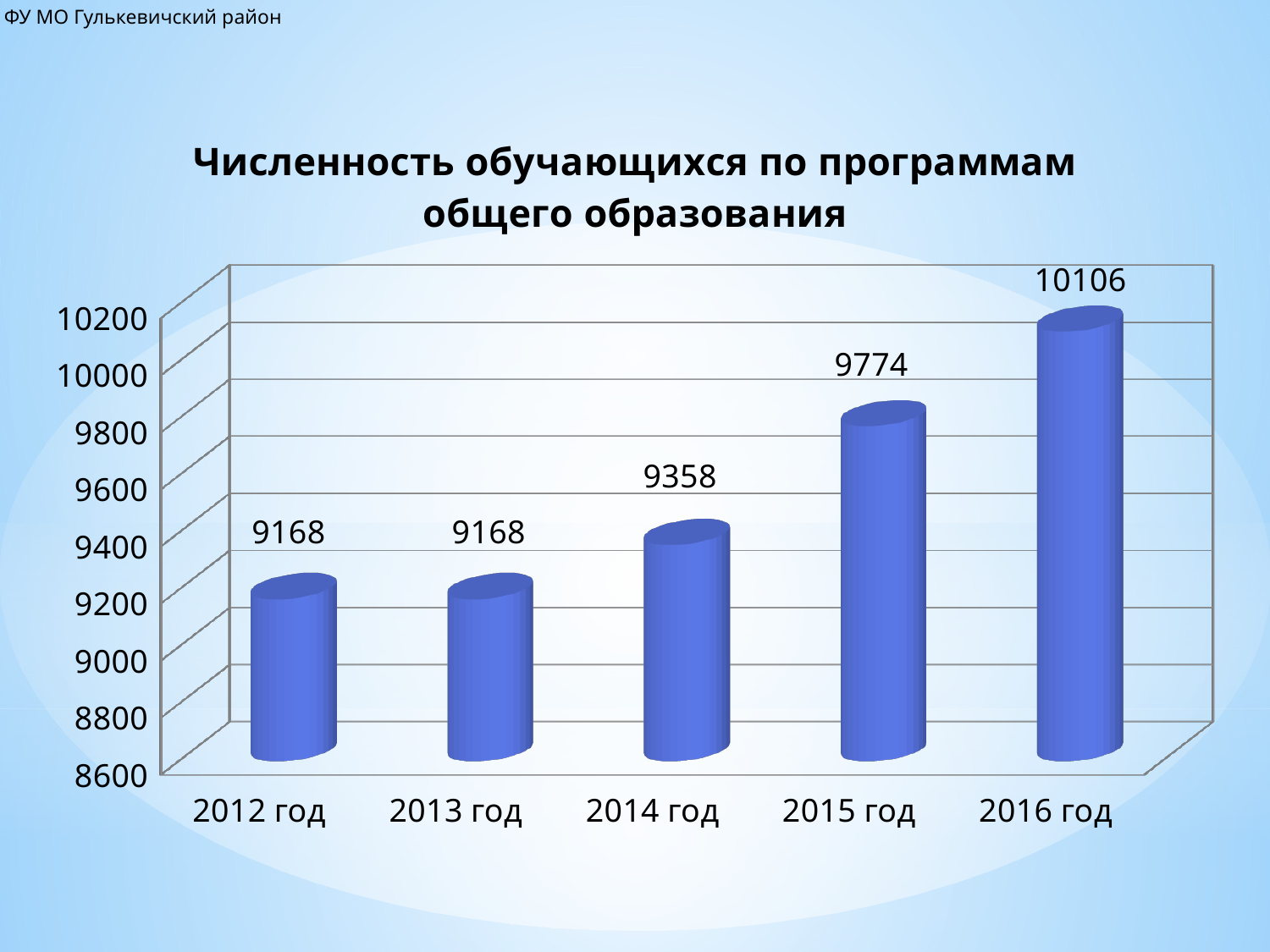
What is the title of the chart? Численность обучающихся по программам общего образования Which year has the highest value? 2016 год What is the difference between the values for 2014 год and 2013 год? 190 Which is larger, the value for 2015 год or the value for 2014 год? 2015 год How many years are shown on the chart? 5 What is the value for 2014 год? 9358 What is the value for 2012 год? 9168 What is the difference between the values for 2016 год and 2015 год? 332 Is the value for 2015 год greater or less than 9600? greater What kind of chart is this? bar chart Do the values rise or fall from 2012 год to 2016 год? rise What is the value for 2016 год? 10106